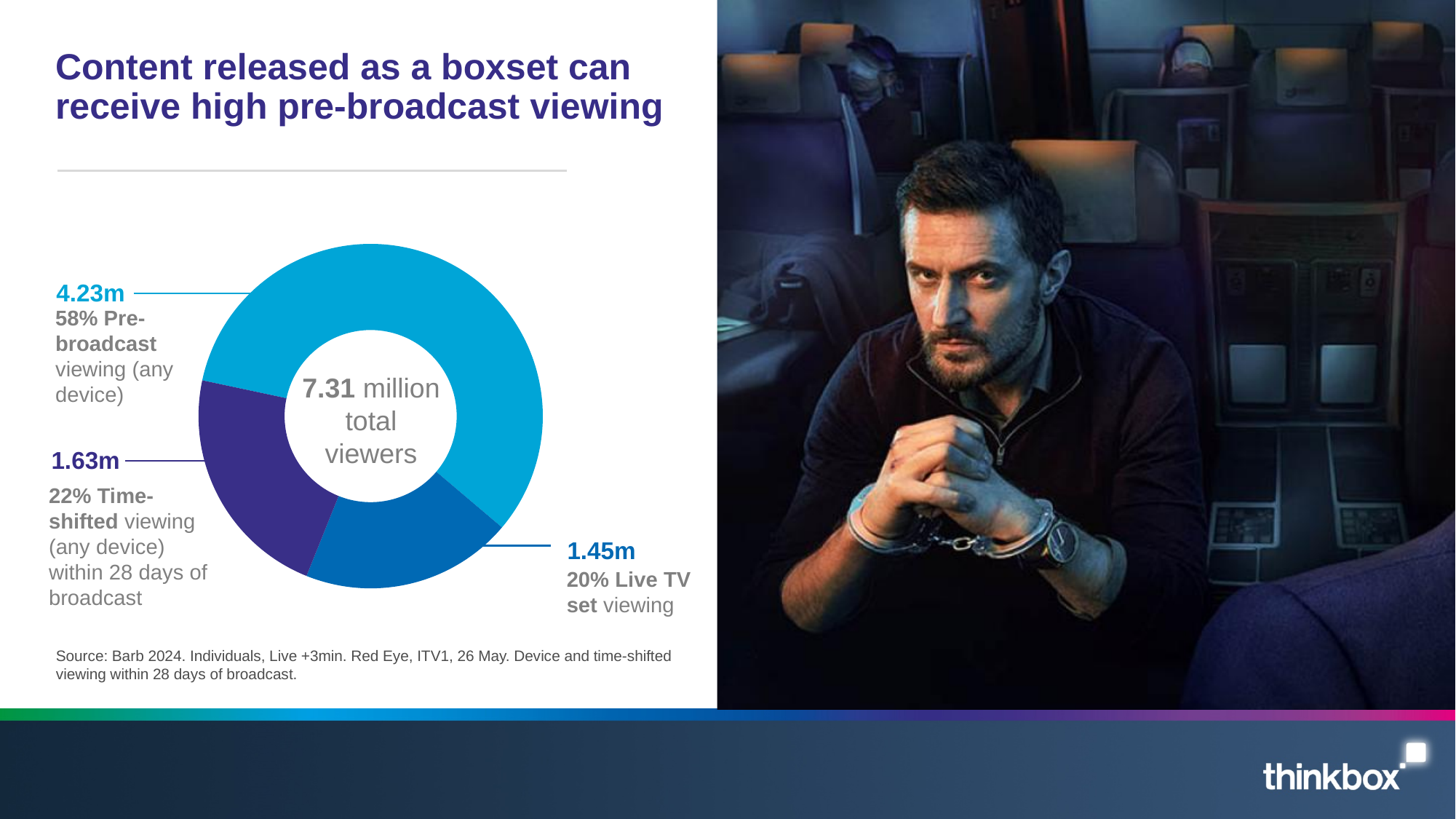
What kind of chart is shown on the slide? Doughnut (pie) chart Which segment of the chart is the largest? Pre-broadcast viewing (any device) What share of total viewing is time-shifted viewing within 28 days of broadcast? 22% How many viewers does the live TV set viewing segment represent? 1.45m How many segments does the doughnut chart have? 3 What share of total viewing is live TV set viewing? 20% What is the difference in viewers between pre-broadcast viewing and live TV set viewing? 2.78m What share of total viewing is pre-broadcast viewing? 58% Which segment of the chart is the smallest? Live TV set viewing How many viewers does the time-shifted viewing segment represent? 1.63m How many viewers does the pre-broadcast viewing (any device) segment represent? 4.23m What is the total number of viewers shown in the centre of the chart? 7.31 million